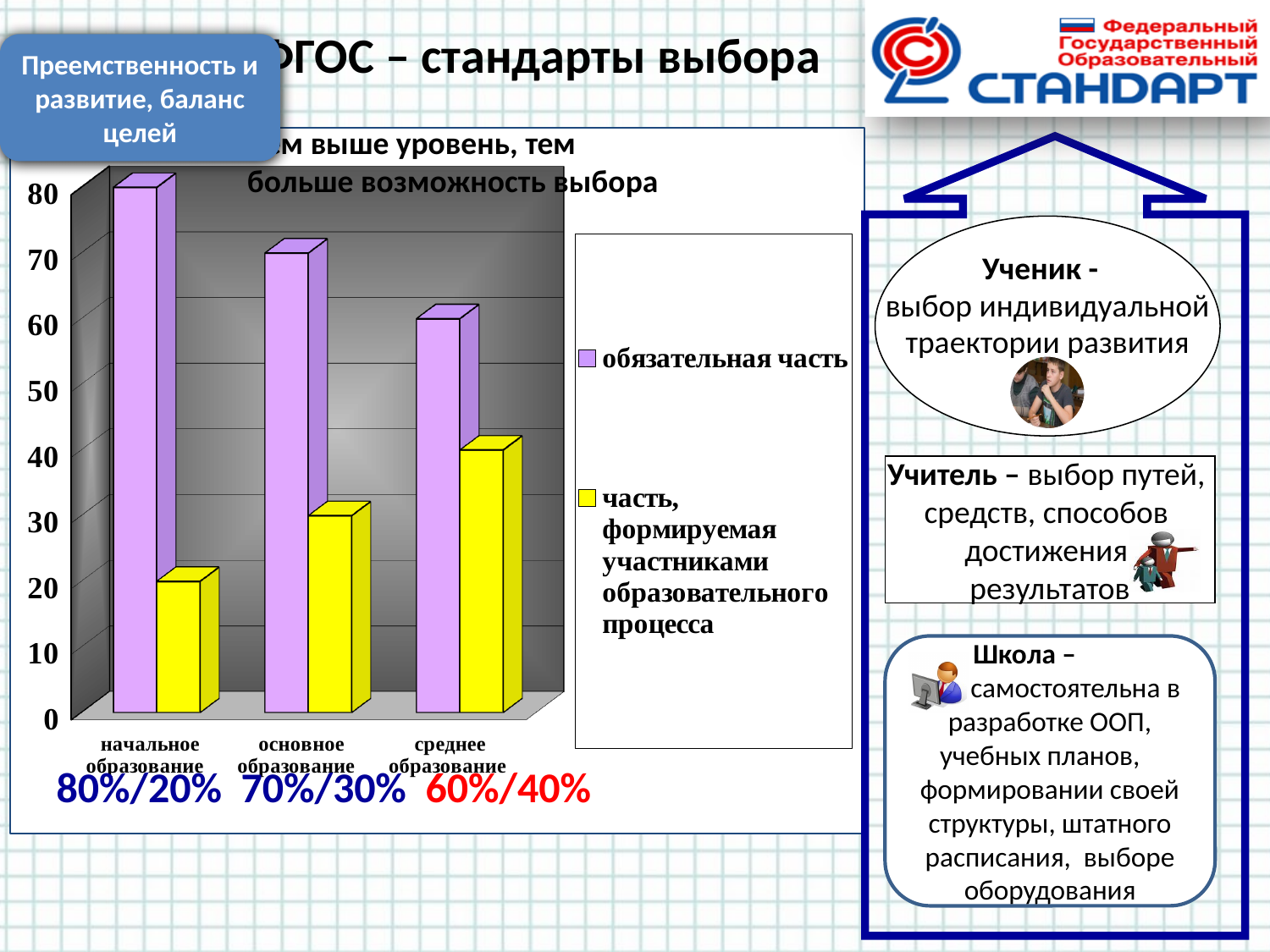
How many education-level categories are shown on the x axis of the chart? 3 For 'среднее образование', which is larger: 'обязательная часть' or 'часть, формируемая участниками образовательного процесса'? обязательная часть What is the value of 'обязательная часть' for 'начальное образование'? 80% What is the difference between 'обязательная часть' and 'часть, формируемая участниками образовательного процесса' for 'начальное образование'? 60% What is the value of 'часть, формируемая участниками образовательного процесса' for 'основное образование'? 30% Which category has the lowest value for 'часть, формируемая участниками образовательного процесса'? начальное образование What kind of chart is shown on the slide? bar chart Does the value of 'обязательная часть' rise or fall from 'начальное образование' to 'среднее образование'? fall What is the value of 'часть, формируемая участниками образовательного процесса' for 'среднее образование'? 40% What colour are the bars for 'обязательная часть' in the chart? purple How many series does the chart legend list? 2 Which category has the highest value for 'обязательная часть'? начальное образование